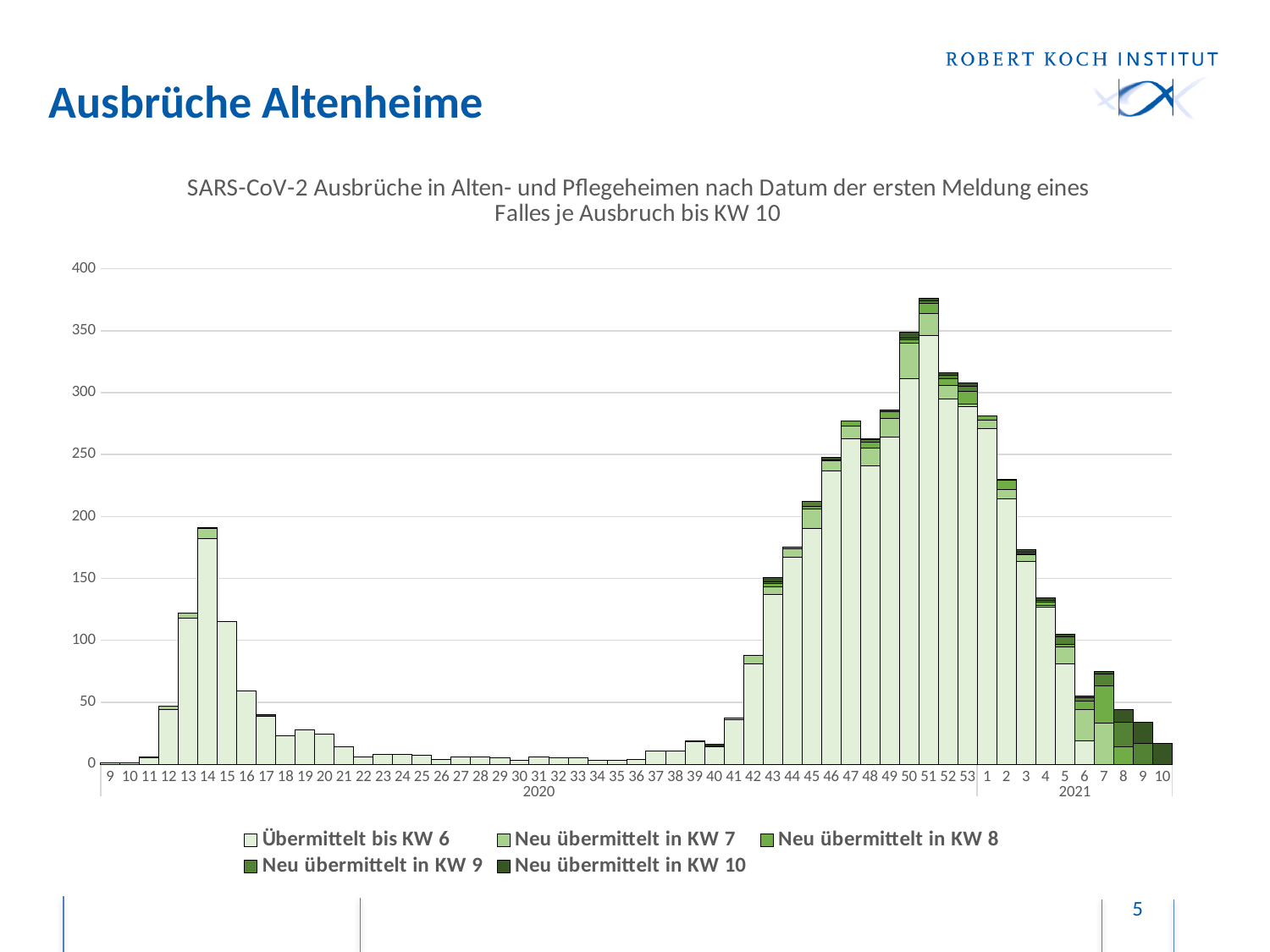
Do the totals rise or fall from week 42 to week 51 of 2020? Rise What is the first legend entry of the chart? Übermittelt bis KW 6 How many series does the legend list? 5 Which has the larger total: week 14 of 2020 or week 51 of 2020? Week 51 of 2020 What kind of chart is shown on the slide? Stacked bar chart Is the total value for week 51 of 2020 greater or less than 350? greater Which calendar week has the highest total number of outbreaks? Week 51 of 2020 Is the total value for week 1 of 2021 greater or less than 250? greater Is the total value for week 14 of 2020 greater or less than 150? greater Which has the larger total: week 16 of 2020 or week 10 of 2021? Week 16 of 2020